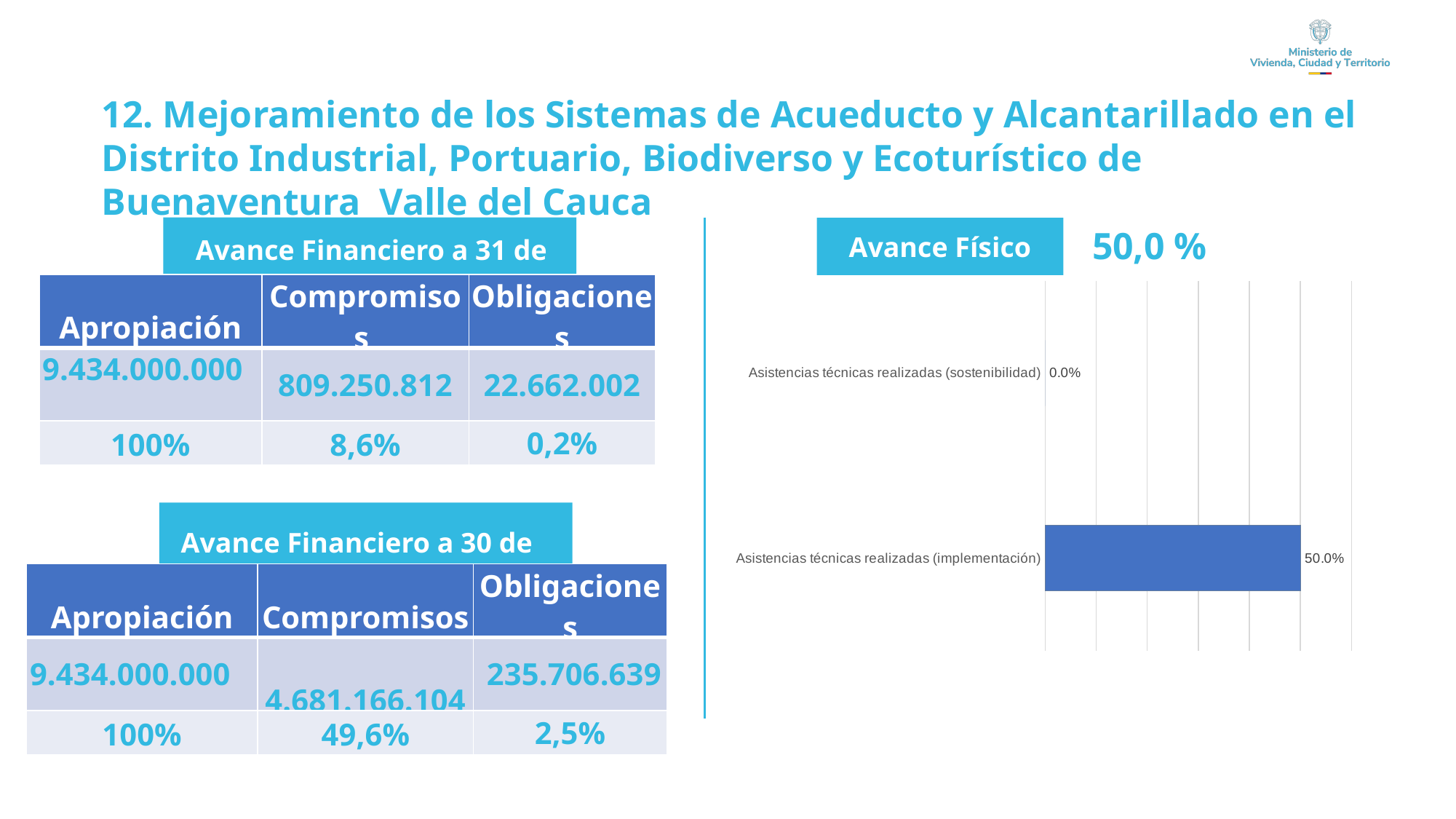
What is the overall percentage shown next to the Avance Físico heading? 50,0 % What is the difference between the implementación and sostenibilidad values in the Avance Físico chart? 50.0% Which category has the highest value in the Avance Físico chart? Asistencias técnicas realizadas (implementación) What is the value for Asistencias técnicas realizadas (implementación) in the Avance Físico chart? 50.0% How many categories are plotted in the Avance Físico chart? 2 What is the heading above the bar chart on the right side of the slide? Avance Físico What kind of chart is shown under Avance Físico? Bar chart Which category has the lowest value in the Avance Físico chart? Asistencias técnicas realizadas (sostenibilidad) In the Avance Físico chart, which is larger: the value for implementación or the value for sostenibilidad? Asistencias técnicas realizadas (implementación) What is the value for Asistencias técnicas realizadas (sostenibilidad) in the Avance Físico chart? 0.0%